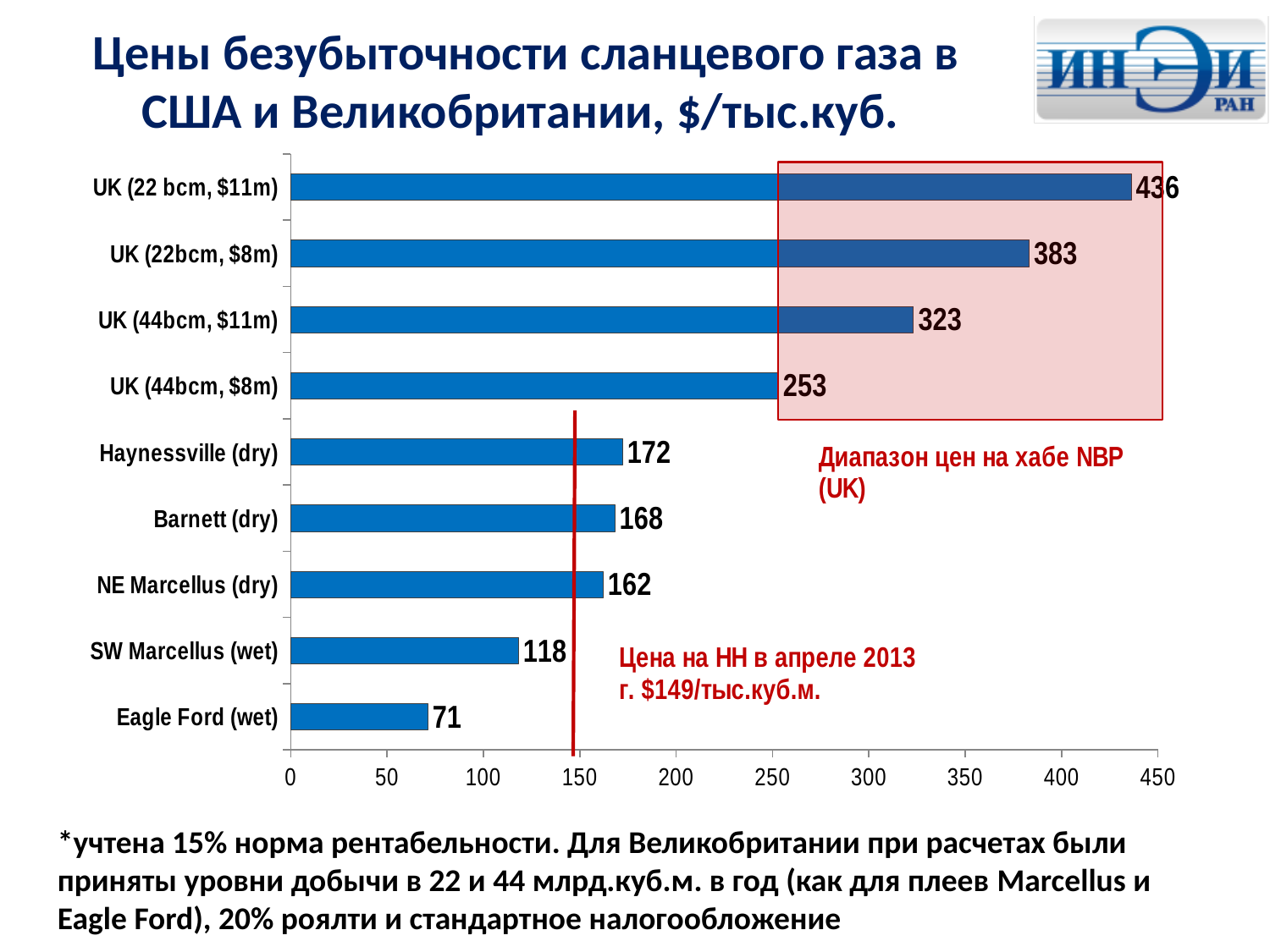
What is the value shown for Eagle Ford (wet)? 71 What kind of chart is shown on the slide? Bar chart What is the maximum value shown on the horizontal axis? 450 What is the value shown for Barnett (dry)? 168 What is the difference between the values for UK (22bcm, $8m) and UK (44bcm, $11m)? 60 What is the breakeven price for UK (22 bcm, $11m)? 436 Which category has the highest value? UK (22 bcm, $11m) How many categories are shown in the chart? 9 What is the value shown for UK (44bcm, $8m)? 253 Which category has the lowest value? Eagle Ford (wet) Which is larger, the value for Haynessville (dry) or SW Marcellus (wet)? Haynessville (dry) Is the value for NE Marcellus (dry) greater or less than 150? greater